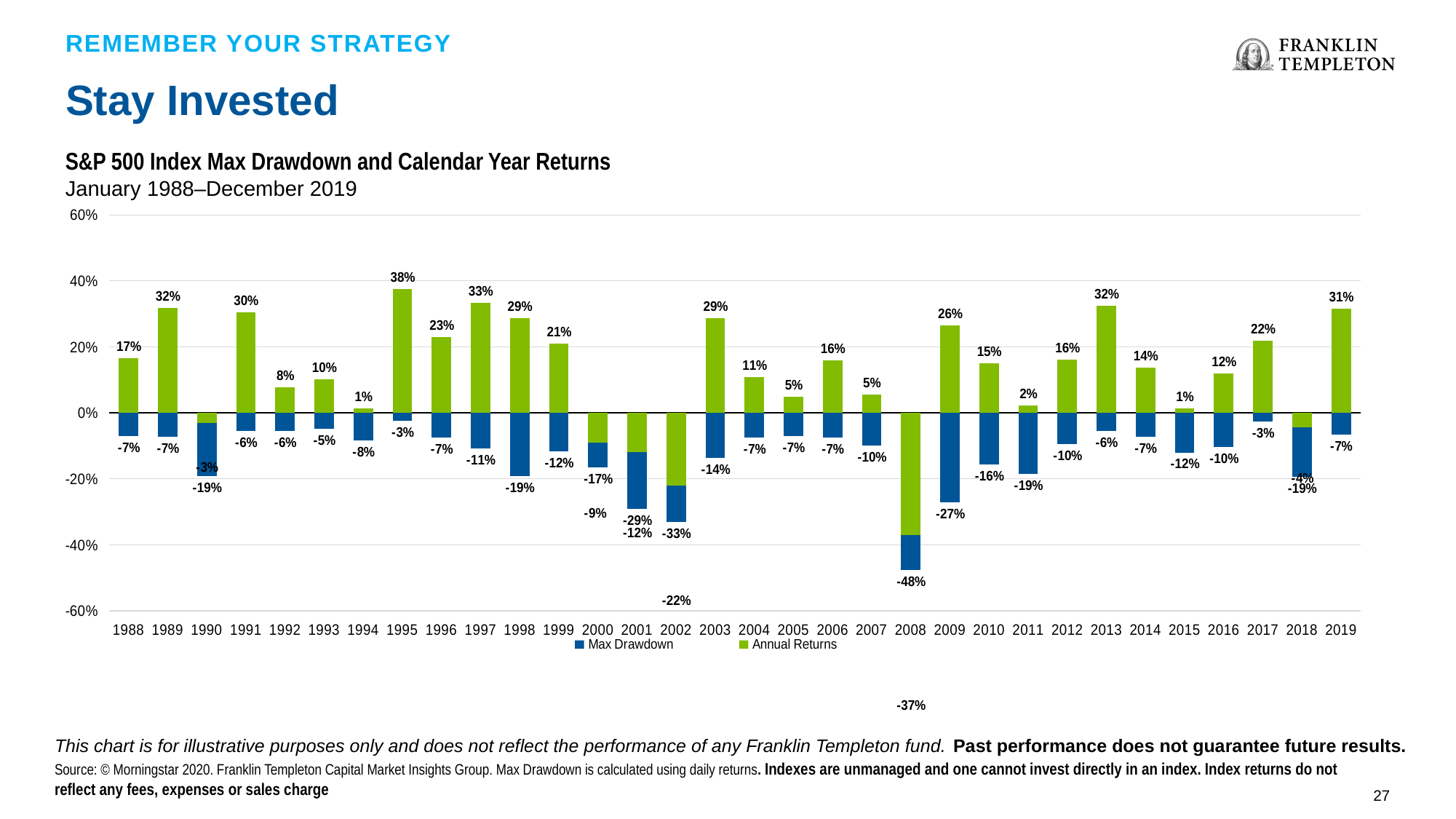
How many years are shown on the x axis? 32 Which is larger, the Annual Returns value for 1997 or for 2003? 1997 What is the Annual Returns value for 1995? 38% What kind of chart is shown on the slide? Bar chart What is the Max Drawdown value for 2008? -48% What is the Max Drawdown value for 2002? -33% Which year has the lowest Annual Returns value? 2008 What is the Annual Returns value for 2019? 31% What is the difference between the Annual Returns values for 1989 and 1988? 15% Which year has the highest Annual Returns value? 1995 How many series does the legend list? 2 What is the title of the chart? S&P 500 Index Max Drawdown and Calendar Year Returns